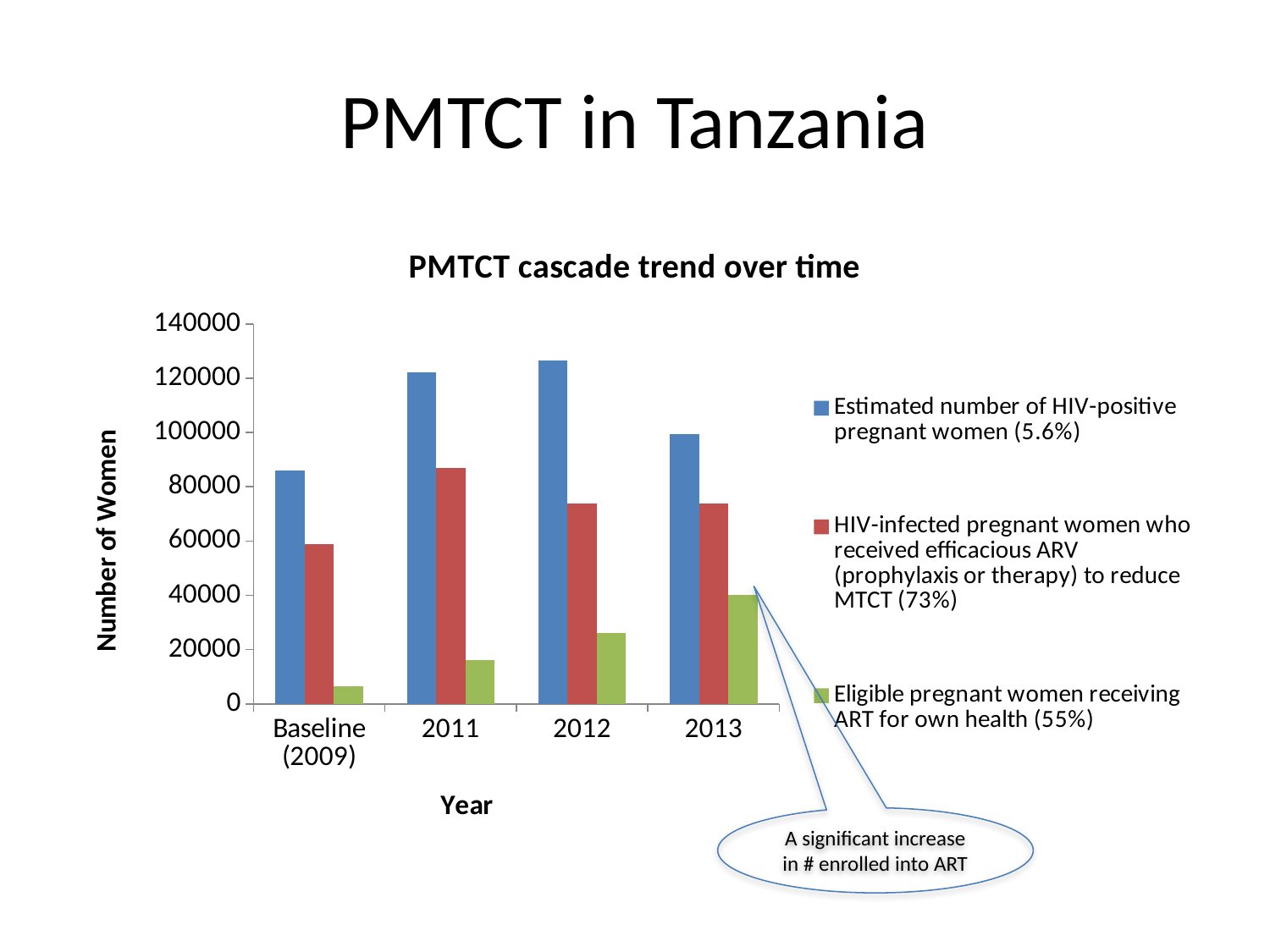
What kind of chart is shown on the slide? Bar chart Is the value for Estimated number of HIV-positive pregnant women (5.6%) in 2012 greater or less than 120000? greater In which year is the value for HIV-infected pregnant women who received efficacious ARV (prophylaxis or therapy) to reduce MTCT (73%) highest? 2011 What is the label of the vertical axis? Number of Women Does the value for Eligible pregnant women receiving ART for own health (55%) rise or fall from Baseline (2009) to 2013? Rise How many series does the legend list? 3 Is the value for Eligible pregnant women receiving ART for own health (55%) at Baseline (2009) greater or less than 20000? less In which year is the value for Eligible pregnant women receiving ART for own health (55%) highest? 2013 What is the title of the chart? PMTCT cascade trend over time In 2013, which is larger: the Estimated number of HIV-positive pregnant women (5.6%) or the HIV-infected pregnant women who received efficacious ARV (73%)? Estimated number of HIV-positive pregnant women (5.6%) In which year is the value for Estimated number of HIV-positive pregnant women (5.6%) lowest? Baseline (2009) How many year categories are shown on the x axis? 4